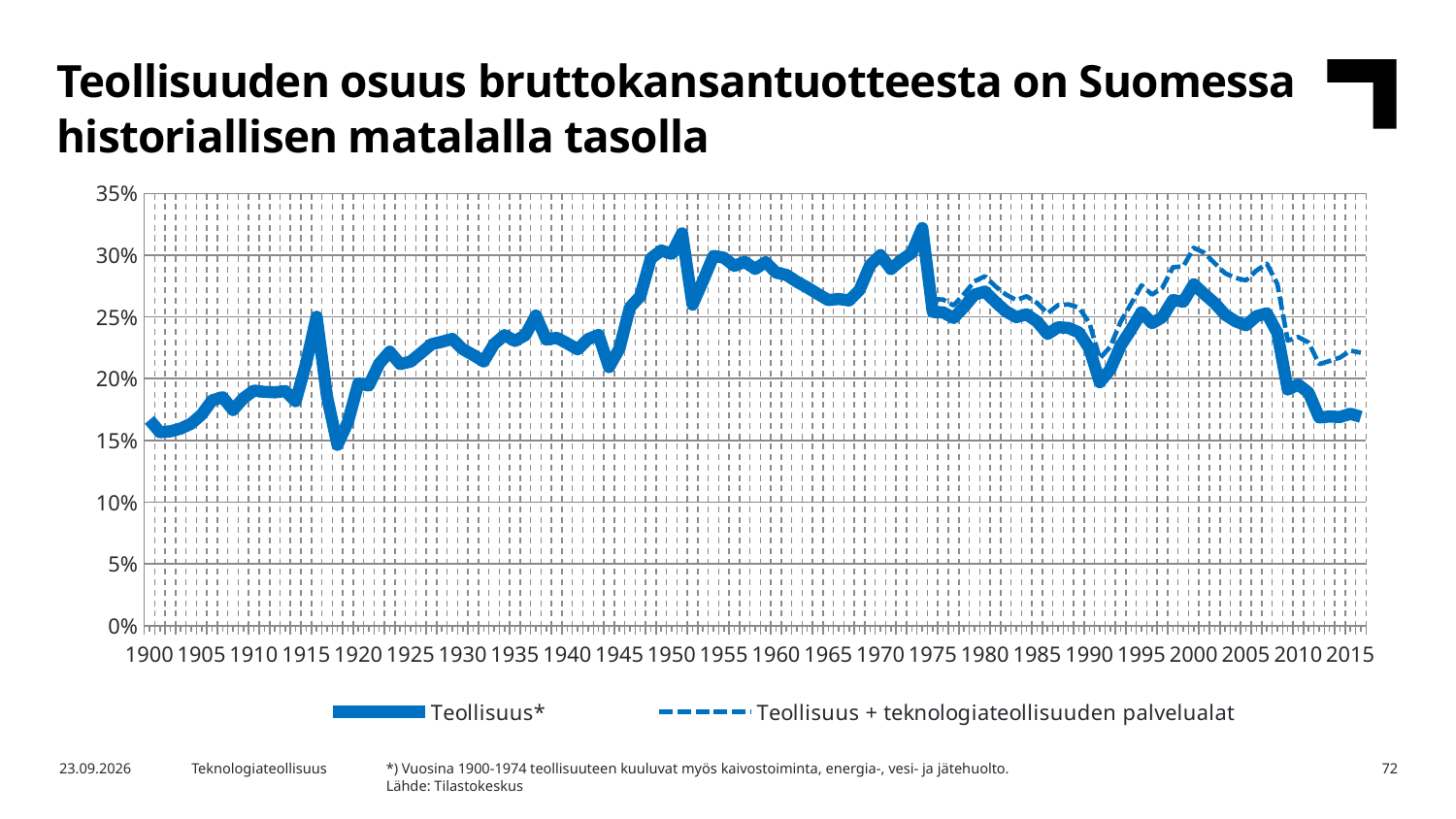
Which is larger for Teollisuus*: the value in 1950 or the value in 2015? 1950 Is the value of Teollisuus* in 1950 greater or less than 25%? greater Is the value of Teollisuus + teknologiateollisuuden palvelualat in 2015 greater or less than 20%? greater Is the value of Teollisuus* in 2015 greater or less than 20%? less In 2010, which series has the higher value: Teollisuus* or Teollisuus + teknologiateollisuuden palvelualat? Teollisuus + teknologiateollisuuden palvelualat What kind of chart is shown on the slide? line chart What is the title of the chart on the slide? Teollisuuden osuus bruttokansantuotteesta on Suomessa historiallisen matalalla tasolla Which series is drawn with a dashed line? Teollisuus + teknologiateollisuuden palvelualat Does the Teollisuus* series rise or fall between 1900 and 1915? rise Does the Teollisuus* series rise or fall between 2000 and 2015? fall How many series does the legend list? 2